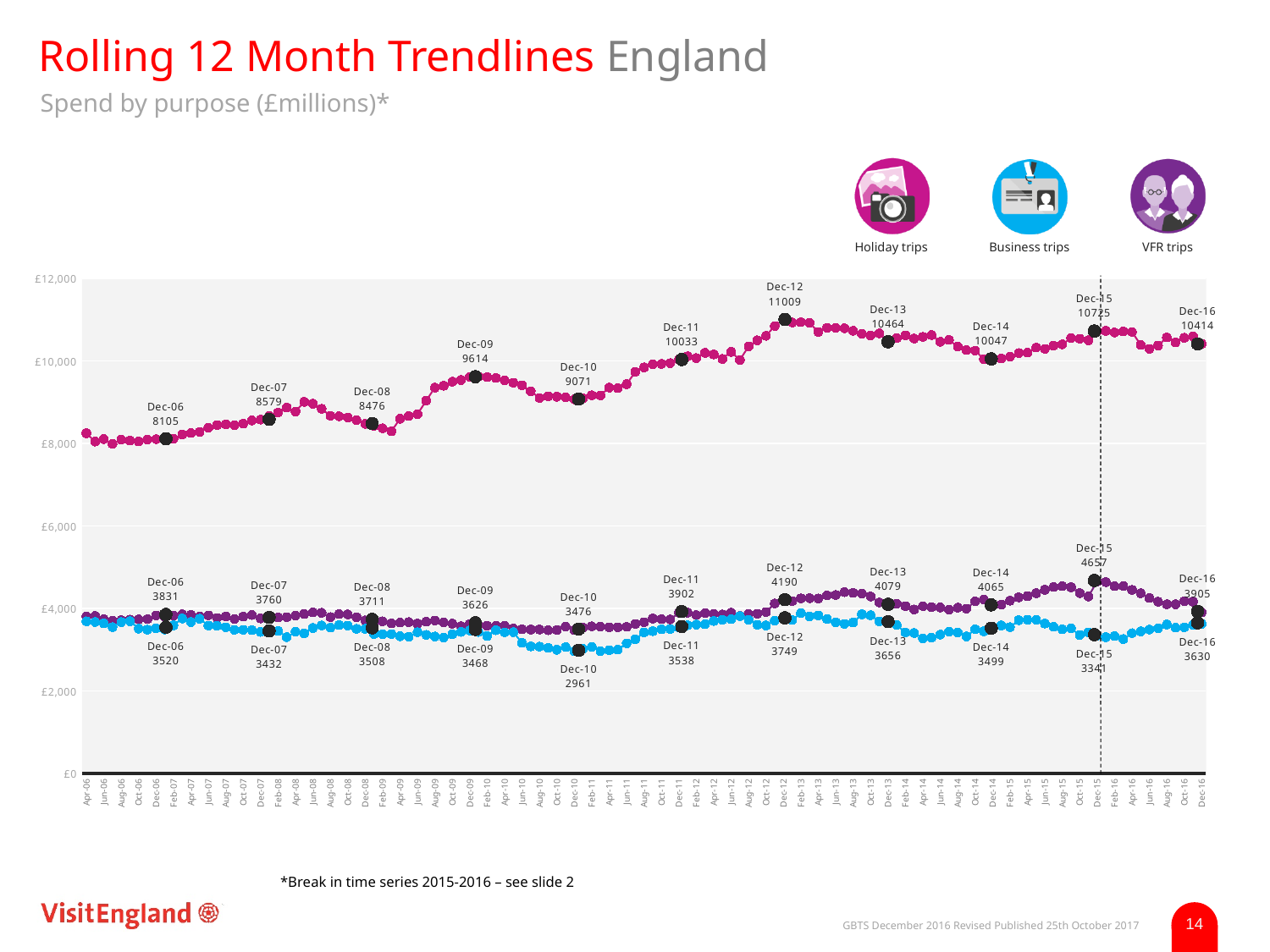
What is the difference between holiday trips spend at Dec-15 and Dec-16? 311 Which was larger at Dec-13: VFR trips spend or business trips spend? VFR trips Is the holiday trips spend at Dec-09 greater or less than £10,000? less What was the business trips spend at Dec-10? 2961 At which labelled December point was business trips spend lowest? Dec-10 Does holiday trips spend generally rise or fall from Dec-06 to Dec-16? rise How many series are shown in the legend? 3 What was the holiday trips spend at Dec-12? 11009 At which labelled December point was holiday trips spend highest? Dec-12 What was the VFR trips spend at Dec-15? 4657 What is the difference between VFR trips spend and business trips spend at Dec-16? 275 What kind of chart is shown on the slide? line chart